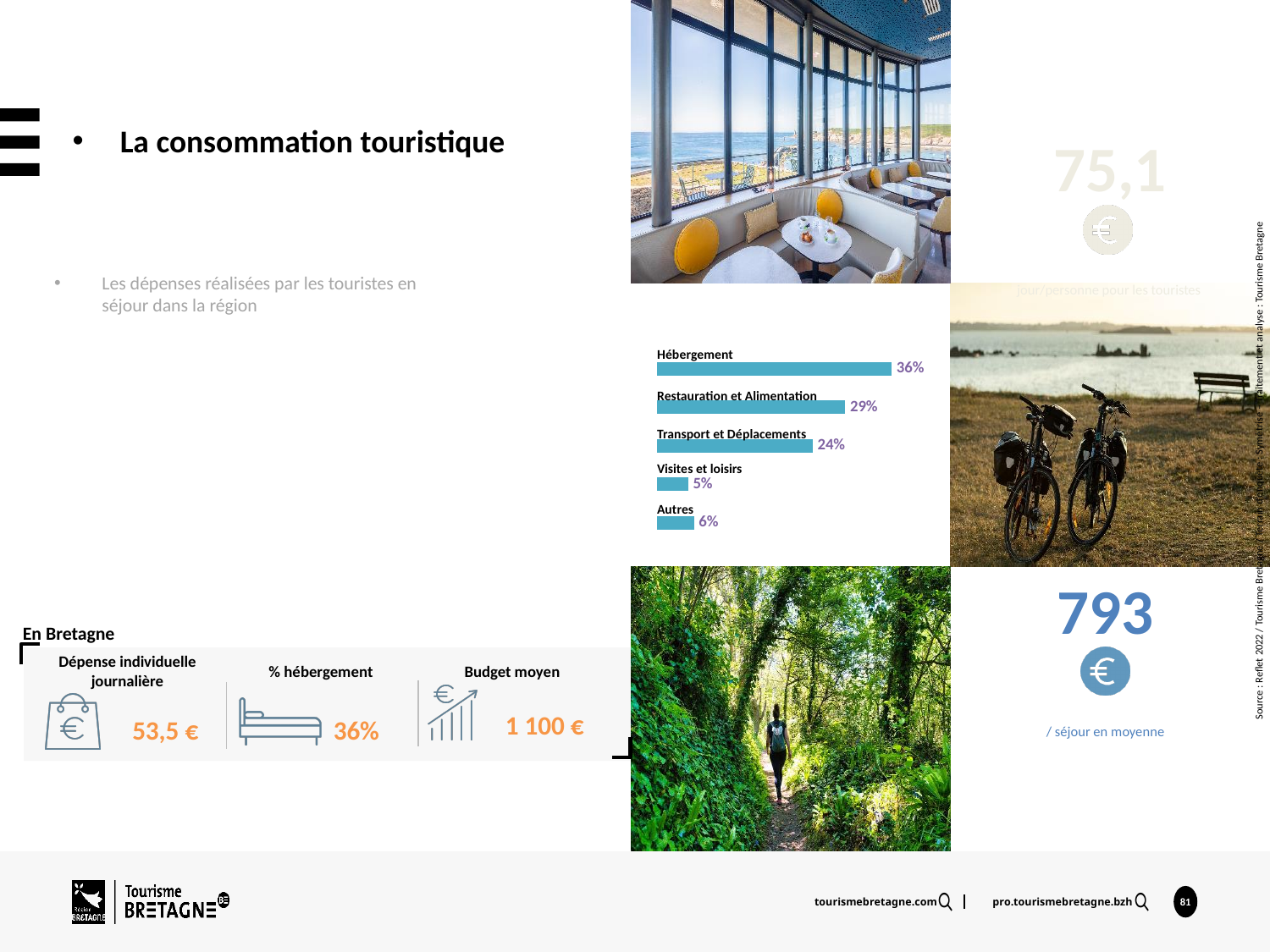
What kind of chart is shown on the slide? Bar chart What is the value for Autres in the bar chart? 6% What is the value for Hébergement in the bar chart? 36% Which category has the highest value in the bar chart? Hébergement Which is larger in the bar chart, Restauration et Alimentation or Transport et Déplacements? Restauration et Alimentation What is the difference between the values for Hébergement and Restauration et Alimentation in the bar chart? 7% Which category has the lowest value in the bar chart? Visites et loisirs What is the difference between the values for Transport et Déplacements and Autres in the bar chart? 18% What is the value for Transport et Déplacements in the bar chart? 24% What is the value for Restauration et Alimentation in the bar chart? 29% What is the value for Visites et loisirs in the bar chart? 5% How many categories are shown in the bar chart? 5